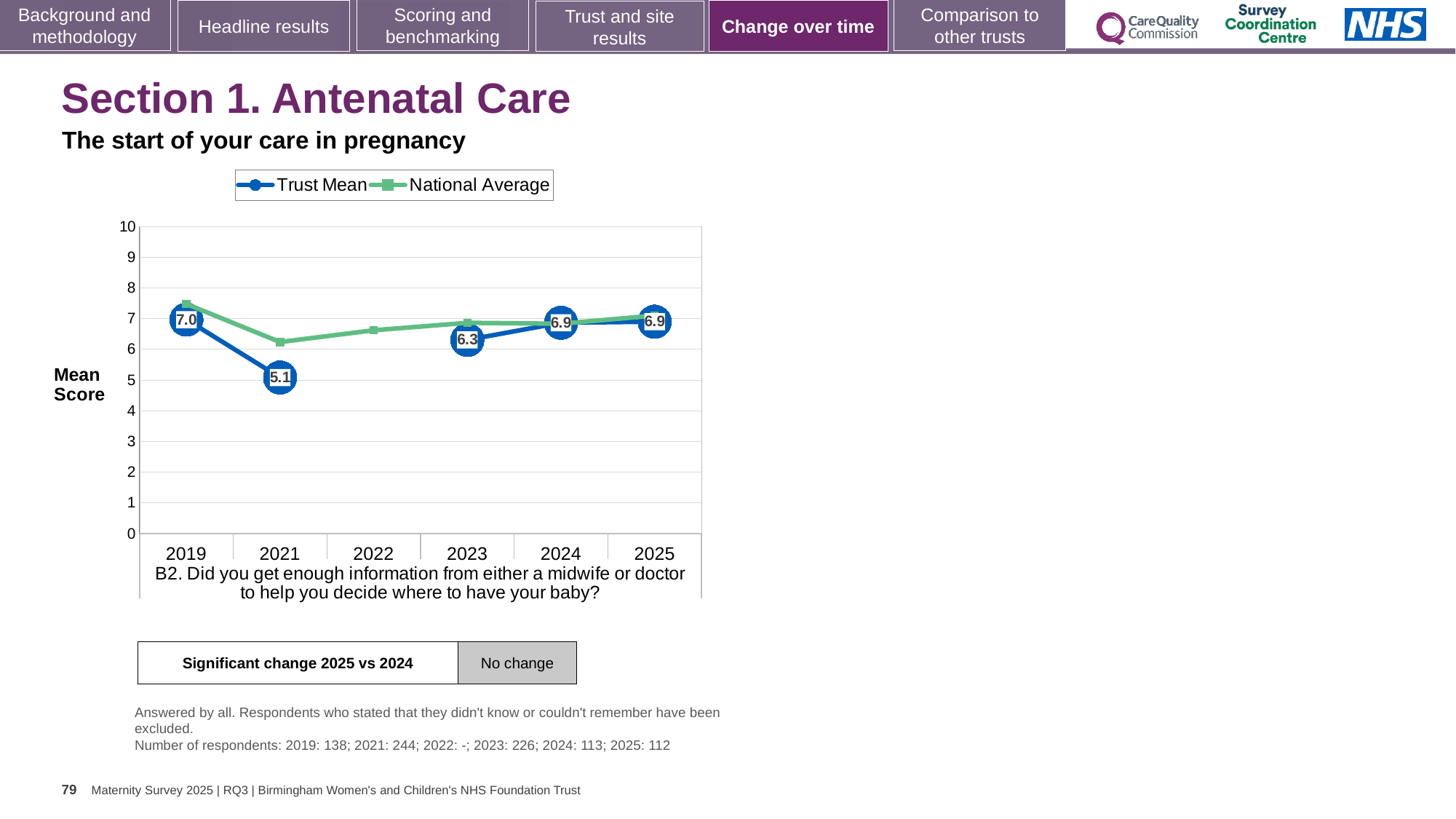
What is the Trust Mean value for 2025? 6.9 What is the difference between the Trust Mean in 2019 and in 2021? 1.9 Is the National Average value for 2021 greater or less than 7? less What kind of chart is shown on the slide? Line chart What is the Trust Mean value for 2023? 6.3 What is the Trust Mean value for 2019? 7.0 How many years are shown on the x axis? 6 How many series does the legend list? 2 In which year is the Trust Mean lowest? 2021 What is the Trust Mean value for 2021? 5.1 Does the Trust Mean rise or fall from 2021 to 2025? Rise Which is larger, the Trust Mean for 2021 or for 2023? 2023